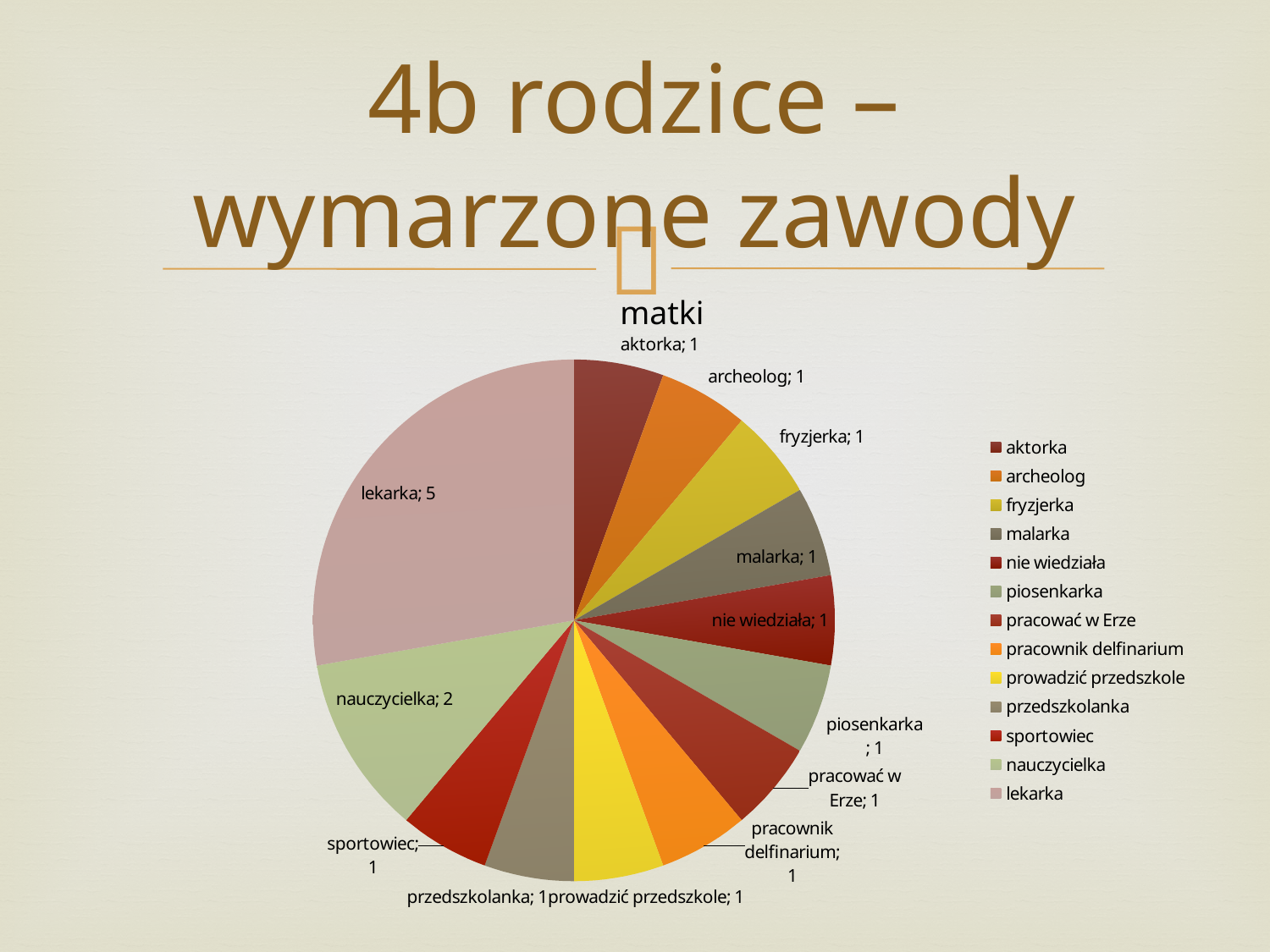
What is the value for lekarka? 5 What is the value for nauczycielka? 2 Which is larger, the value for nauczycielka or the value for malarka? nauczycielka What is the value for pracownik delfinarium? 1 What is the difference between the values for lekarka and nauczycielka? 3 Which category has the largest slice of the pie? lekarka How many categories have a value of 1? 11 What is the value for sportowiec? 1 What is the title of the chart? matki Which legend entry is listed last? lekarka How many categories does the pie chart have? 13 What kind of chart is shown on the slide? pie chart